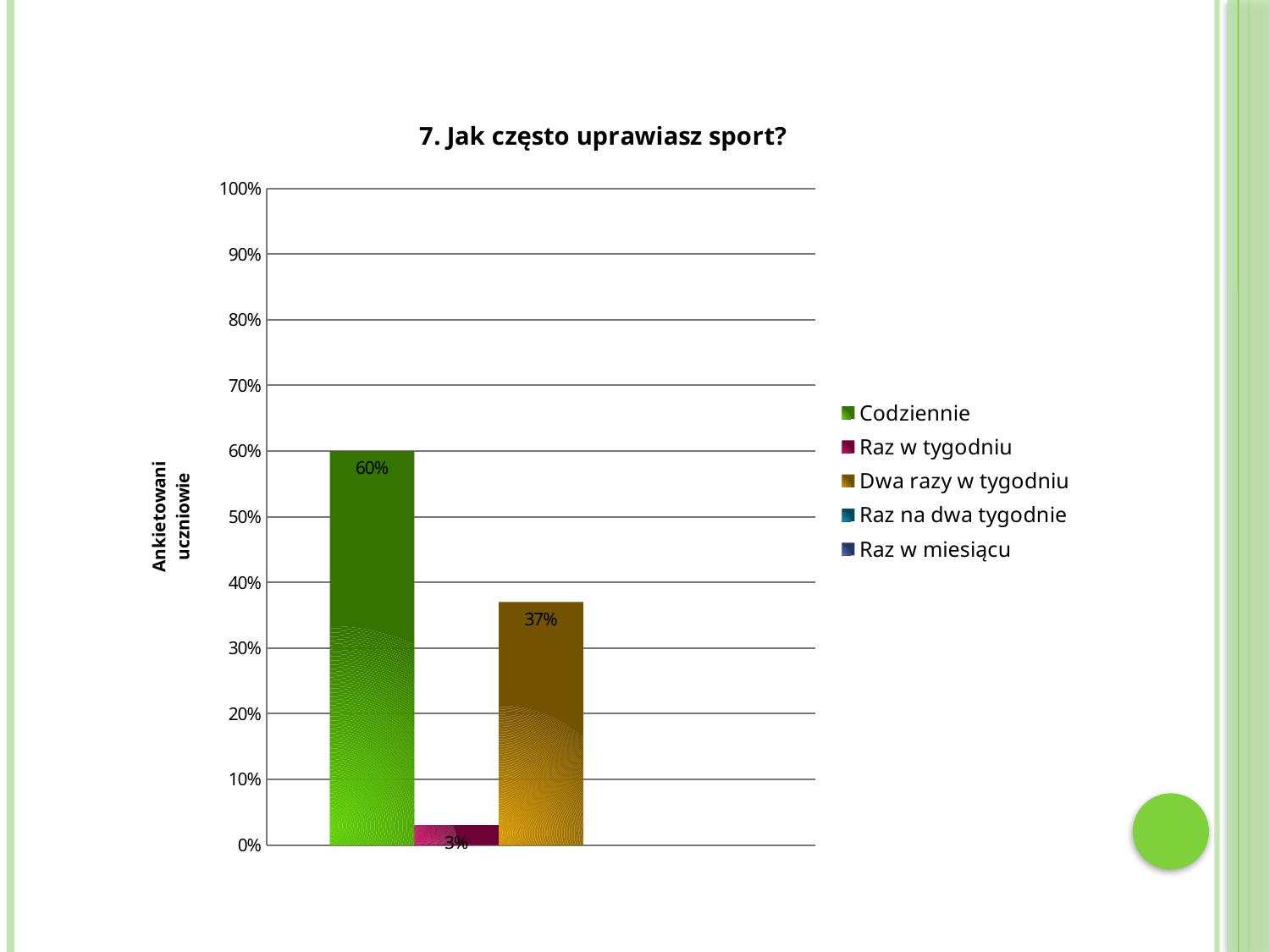
What is the title of the chart? 7. Jak często uprawiasz sport? What is the difference between the values for Codziennie and Dwa razy w tygodniu? 23 percentage points Which category has the highest value? Codziennie What is the difference between the values for Dwa razy w tygodniu and Raz w tygodniu? 34 percentage points What is the value for Dwa razy w tygodniu? 37% Which is larger, the value for Codziennie or the value for Dwa razy w tygodniu? Codziennie What is the value for Raz w tygodniu? 3% What is the value for Codziennie? 60% How many series does the legend list? 5 Is the value for Codziennie greater or less than 50%? greater Among the bars shown on the chart, which category has the lowest value? Raz w tygodniu What kind of chart is shown on the slide? bar chart